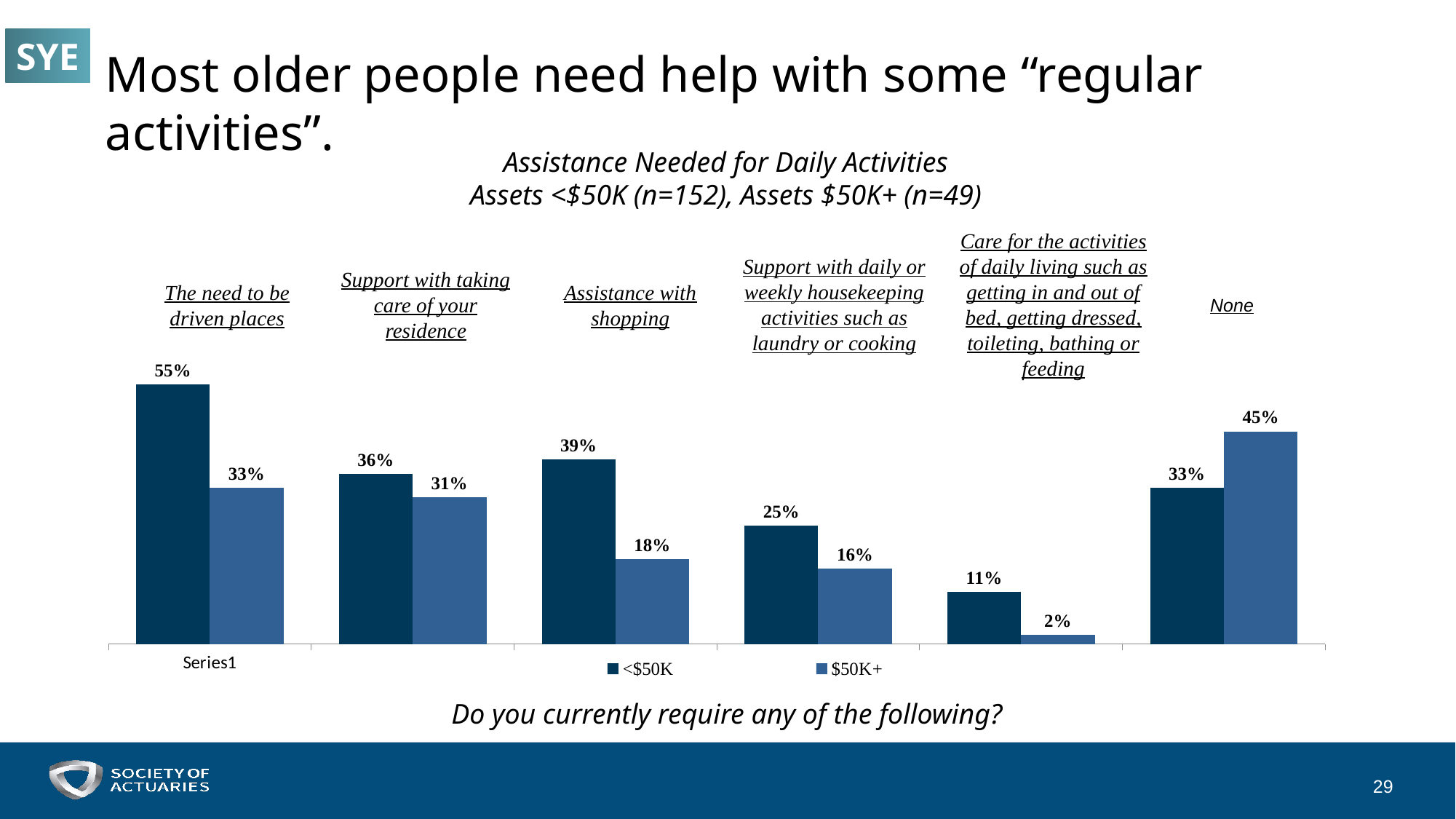
What percentage of the $50K+ group selected None? 45% Which category has the lowest value for the $50K+ series? Care for the activities of daily living such as getting in and out of bed, getting dressed, toileting, bathing or feeding How many series does the legend list? 2 For the None category, which series has the larger value, <$50K or $50K+? $50K+ Which category has the highest value for the <$50K series? The need to be driven places What is the sample size (n) for the Assets $50K+ group according to the chart title? 49 What percentage of the <$50K group reports the need to be driven places? 55% What is the difference between the <$50K and $50K+ values for the need to be driven places? 22 percentage points What type of chart is shown on the slide? Bar chart How many activity categories are shown on the chart? 6 What percentage of the $50K+ group reports needing assistance with shopping? 18% What percentage of the <$50K group needs support with daily or weekly housekeeping activities such as laundry or cooking? 25%